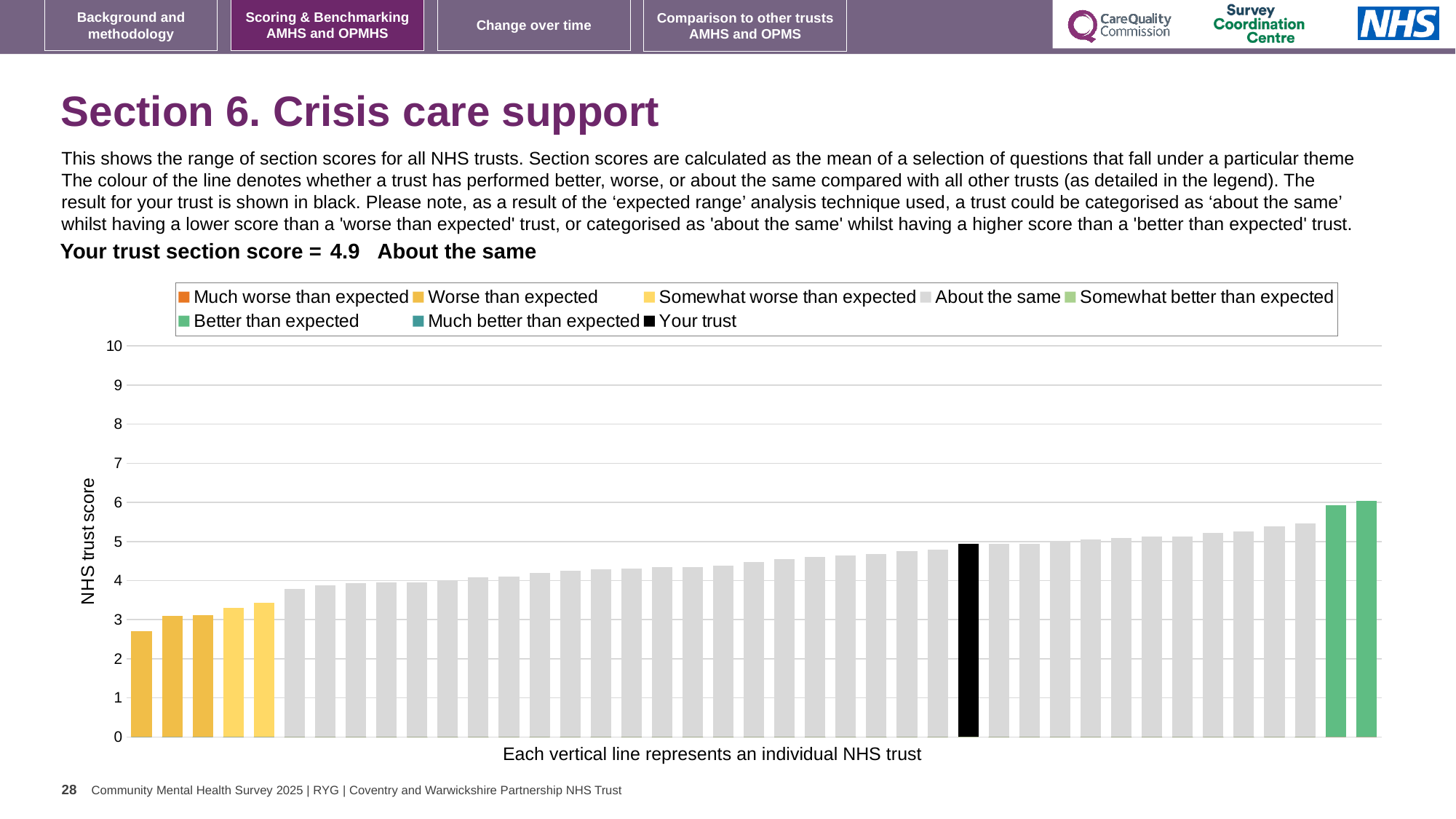
Do the bar values rise or fall from left to right along the x axis? Rise Is the value of the highest bar in the chart greater or less than 7? less How many bars are coloured as 'Worse than expected' (dark yellow)? 3 What is the title of the vertical axis? NHS trust score Is the value of the lowest bar in the chart greater or less than 3? less What kind of chart is shown on the slide? Bar chart How many bars are coloured as 'Better than expected' (green)? 2 Which performance category is your trust placed in for this section? About the same Is the value of the black 'Your trust' bar greater or less than 4? greater What is the section score for your trust shown on the slide? 4.9 How many entries does the chart legend list? 8 Which legend category do the highest bars in the chart belong to? Better than expected